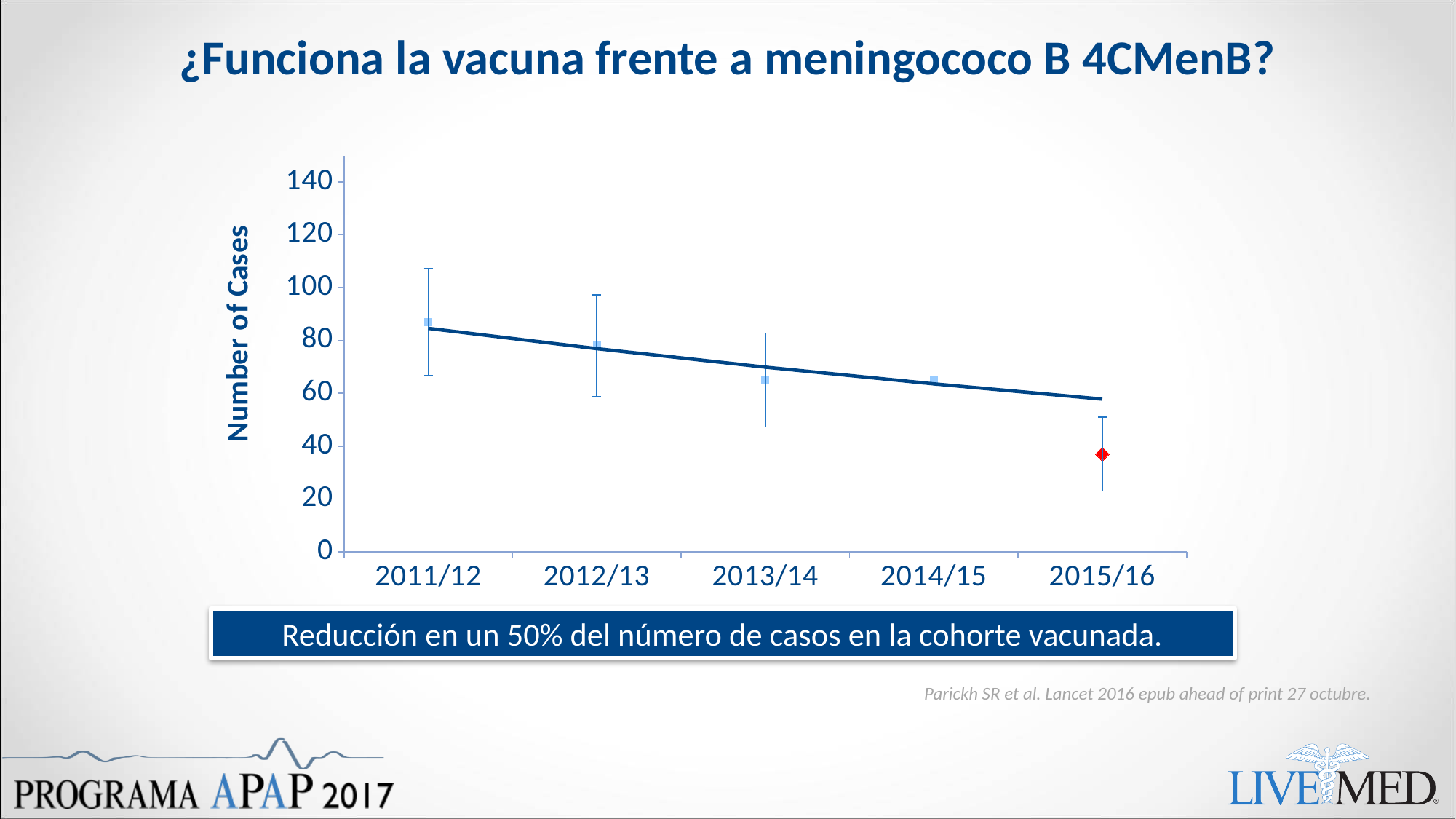
Is the value for 2014/15 greater or less than 80? less Is the value for 2015/16 greater or less than 20? greater Is the value for 2015/16 greater or less than 40? less Do the number of cases rise or fall from 2011/12 to 2015/16? Fall What is the label of the y axis? Number of Cases Which season has the lowest number of cases? 2015/16 Which season has the highest number of cases? 2011/12 Which has more cases, 2011/12 or 2015/16? 2011/12 What kind of chart is shown on the slide? Line chart with error bars How many seasons (data points) are plotted on the x axis? 5 Which season's data point is marked with a red diamond? 2015/16